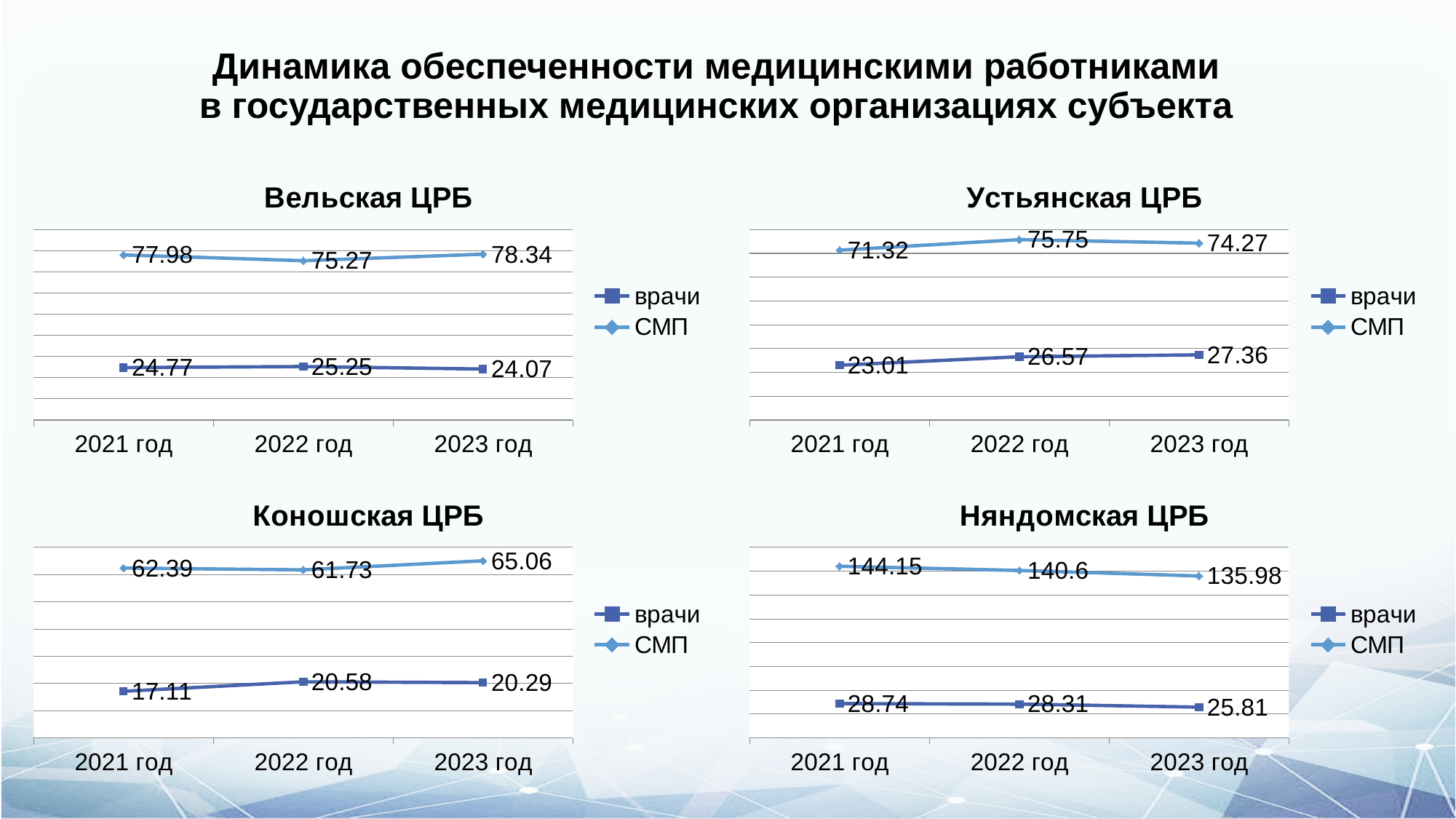
In the Коношская ЦРБ chart, in which year is the врачи value lowest? 2021 год In the Няндомская ЦРБ chart, in which year is the СМП value highest? 2021 год How many series does the legend of the Устьянская ЦРБ chart list? 2 In the Вельская ЦРБ chart, what is the value for СМП in 2023 год? 78.34 In the Коношская ЦРБ chart, what is the value for СМП in 2022 год? 61.73 In the Устьянская ЦРБ chart, what is the value for врачи in 2021 год? 23.01 In the Няндомская ЦРБ chart, what is the value for врачи in 2023 год? 25.81 In the Устьянская ЦРБ chart, by how much did the врачи value increase from 2021 год to 2023 год? 4.35 In the Няндомская ЦРБ chart, does the СМП series rise or fall from 2021 год to 2023 год? fall What kind of chart is the Коношская ЦРБ chart? line chart In the Няндомская ЦРБ chart, what is the difference between the СМП values for 2021 год and 2023 год? 8.17 In the Вельская ЦРБ chart, which is larger: the СМП value in 2021 год or in 2022 год? 2021 год